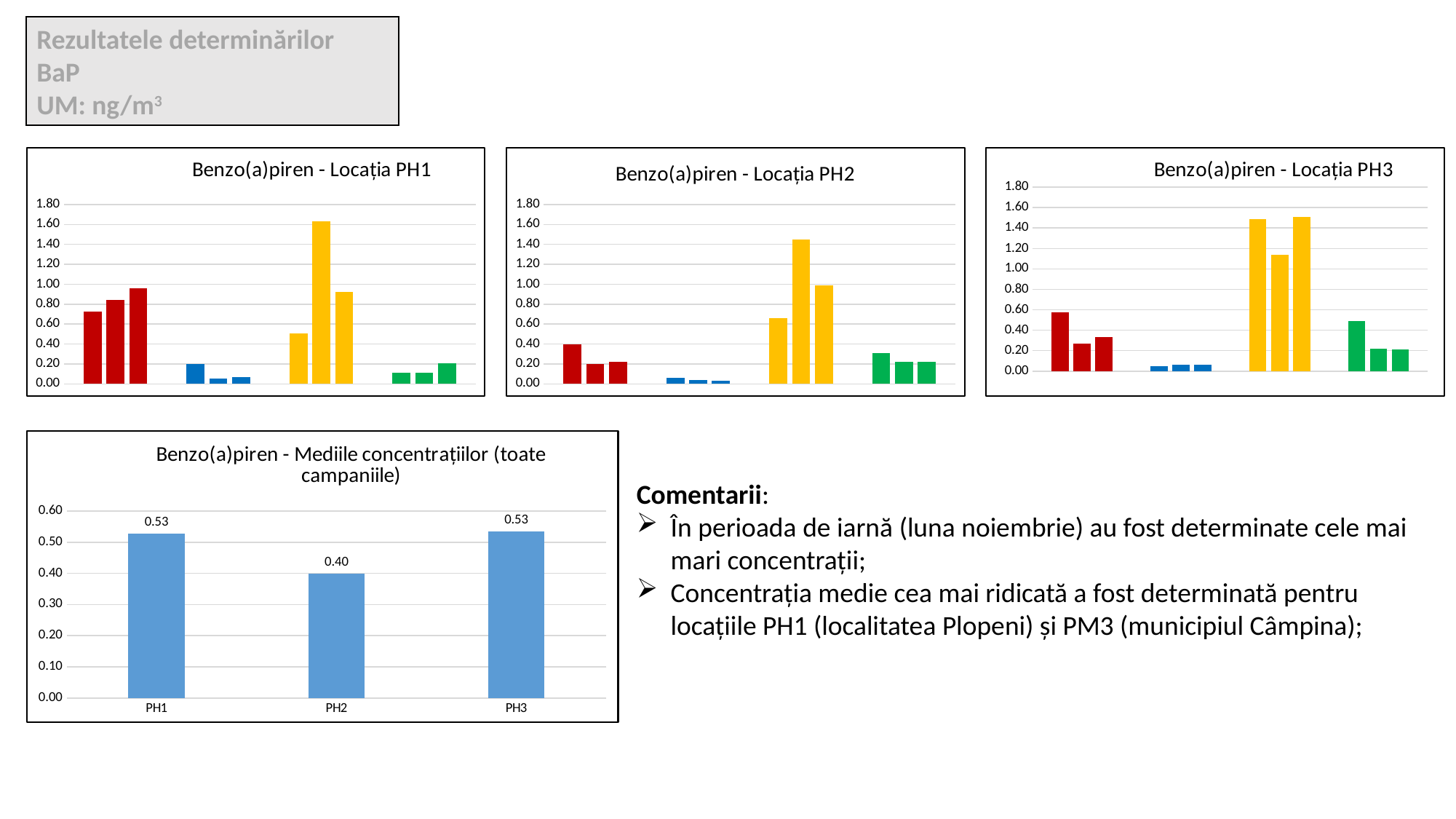
How many bars are plotted in the chart 'Benzo(a)piren - Locația PH3'? 12 In the chart 'Benzo(a)piren - Mediile concentrațiilor (toate campaniile)', what is the value for PH3? 0.53 In the chart 'Benzo(a)piren - Mediile concentrațiilor (toate campaniile)', what is the difference between the values for PH1 and PH2? 0.13 In the chart 'Benzo(a)piren - Locația PH1', is the tallest bar greater or less than 1.40? greater What kind of chart is 'Benzo(a)piren - Mediile concentrațiilor (toate campaniile)'? bar chart In the chart 'Benzo(a)piren - Mediile concentrațiilor (toate campaniile)', how many locations are shown? 3 What is the title of the chart in the top-right position on the slide? Benzo(a)piren - Locația PH3 In the chart 'Benzo(a)piren - Mediile concentrațiilor (toate campaniile)', what is the value for PH1? 0.53 In the chart 'Benzo(a)piren - Mediile concentrațiilor (toate campaniile)', what is the value for PH2? 0.40 In the chart 'Benzo(a)piren - Locația PH2', is the tallest bar greater or less than 1.20? greater In the chart 'Benzo(a)piren - Mediile concentrațiilor (toate campaniile)', which is larger, the value for PH2 or the value for PH3? PH3 In the chart 'Benzo(a)piren - Mediile concentrațiilor (toate campaniile)', which location has the lowest value? PH2